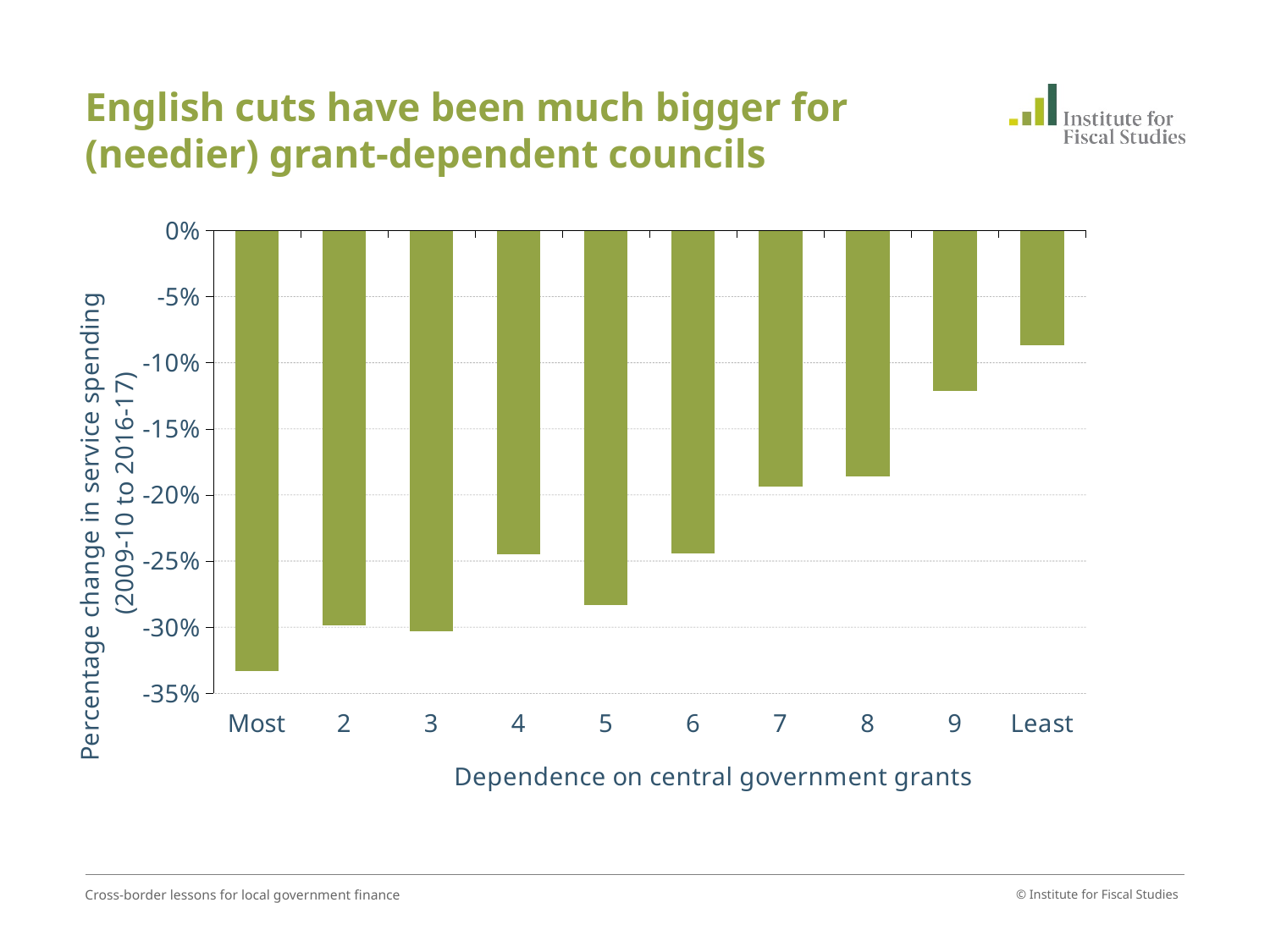
What kind of chart is shown on the slide? bar chart How many categories are shown along the x axis? 10 What is the title of the x axis? Dependence on central government grants Which has the larger cut in service spending, category 9 or 'Least'? 9 Is the value for the 'Least' grant-dependent category greater or less than -10%? greater Is the value for category 9 greater or less than -15%? greater Is the value for the 'Most' grant-dependent category greater or less than -30%? less Which category has the largest percentage cut in service spending (the lowest value)? Most Which category has the smallest percentage cut in service spending (the highest value)? Least Which has the larger cut in service spending, category 5 or category 4? 5 Moving from 'Most' to 'Least' dependence on grants, do the values generally rise or fall? rise